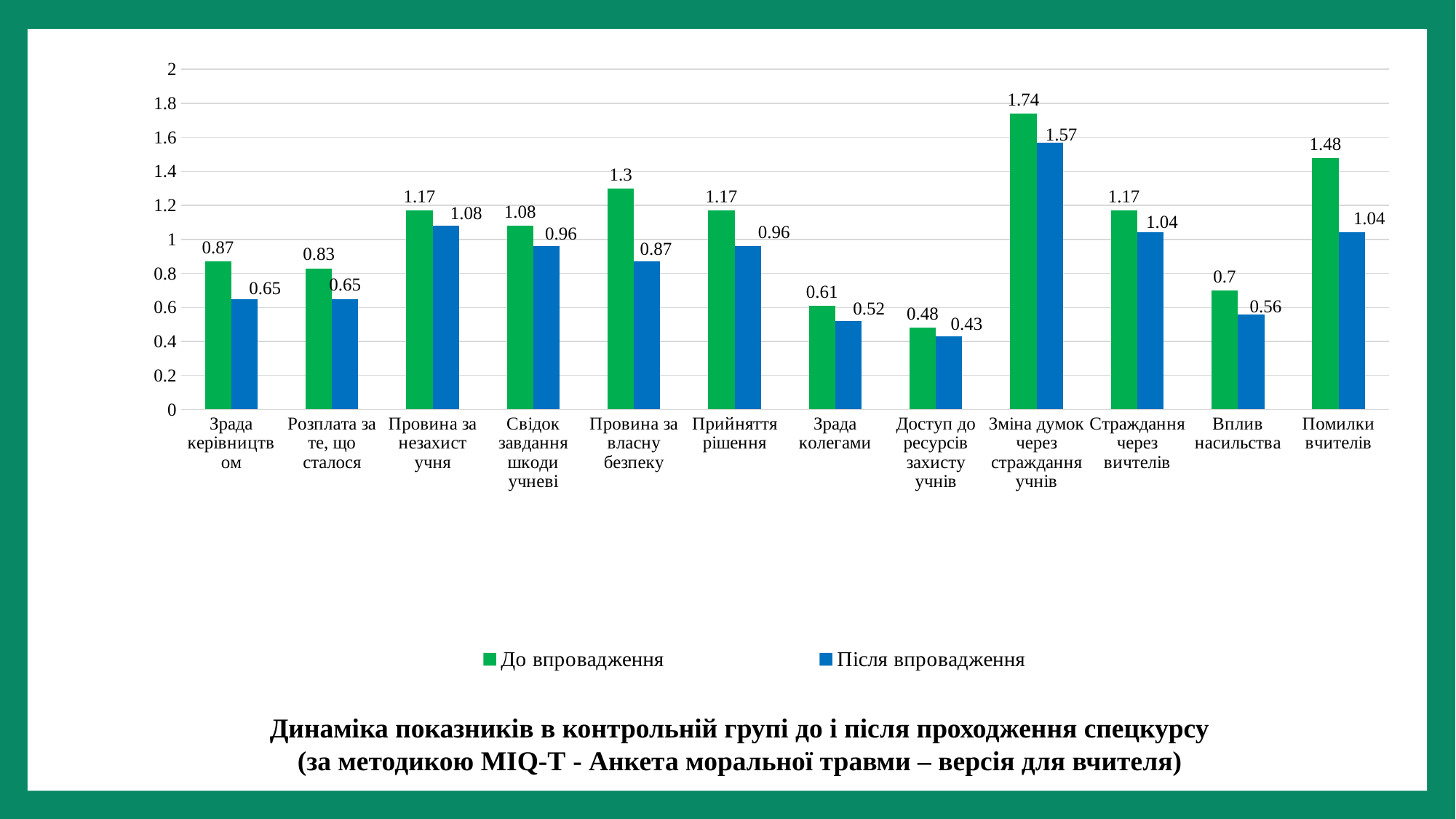
What is the difference between the "До впровадження" and "Після впровадження" values for "Провина за власну безпеку"? 0.43 What is the difference between the "До впровадження" and "Після впровадження" values for "Помилки вчителів"? 0.44 Which category has the lowest value in the "Після впровадження" series? Доступ до ресурсів захисту учнів What is the value for "Помилки вчителів" in the "Після впровадження" series? 1.04 What is the value for "Доступ до ресурсів захисту учнів" in the "Після впровадження" series? 0.43 How many series does the legend list? 2 Which category has the highest value in the "До впровадження" series? Зміна думок через страждання учнів Which is larger: the "До впровадження" value for "Вплив насильства" or the "До впровадження" value for "Зрада колегами"? Вплив насильства What is the value for "Зміна думок через страждання учнів" in the "До впровадження" series? 1.74 Which colour represents the "Після впровадження" series? Blue How many categories are shown on the x axis? 12 What kind of chart is shown on the slide? Bar chart